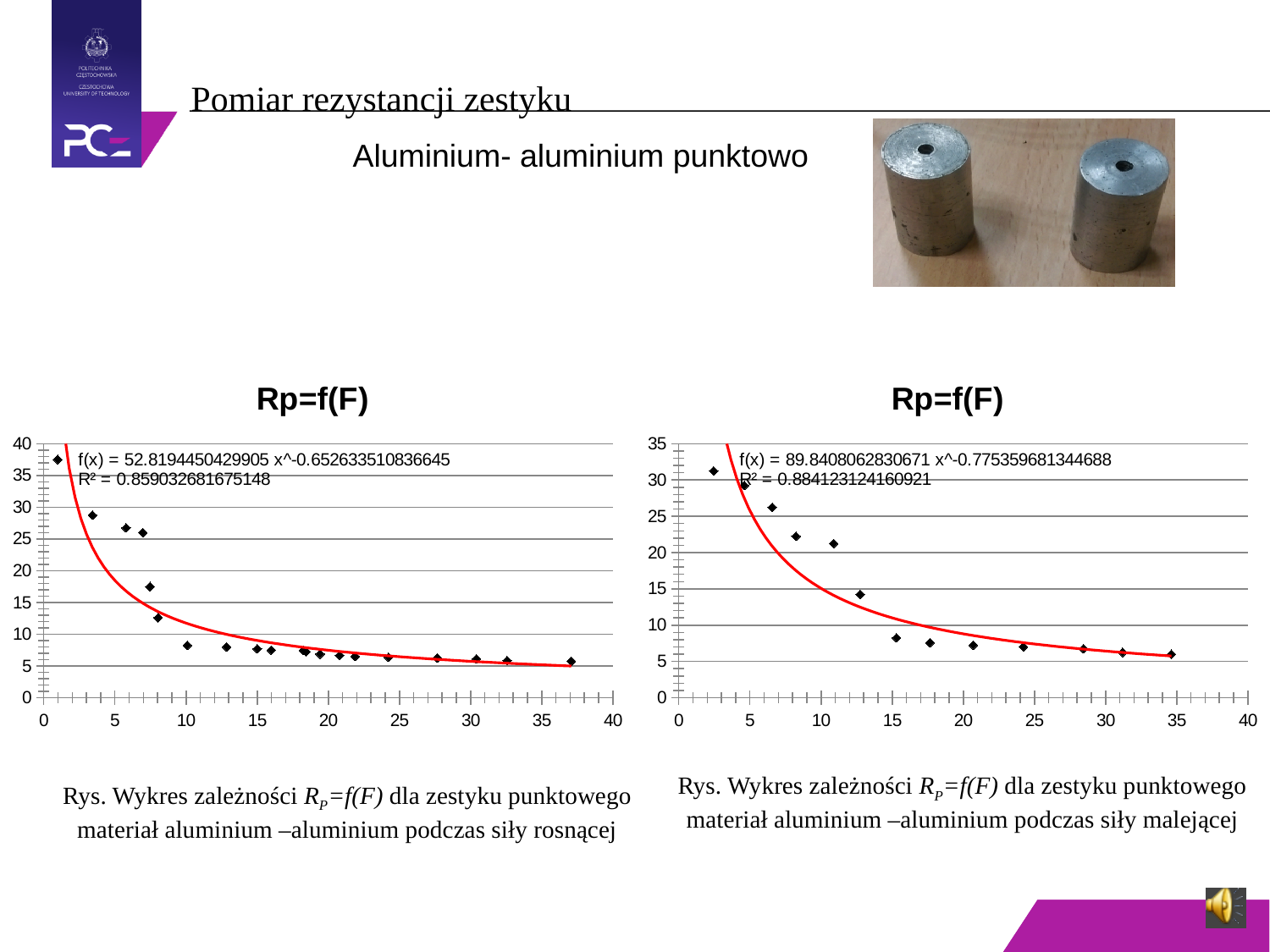
In the right chart, is the Rp value at about F=13 larger or smaller than the Rp value at about F=31? larger In the left chart, which plotted point has the highest Rp value: the leftmost point or the rightmost point? the leftmost point In the left chart, is the value of the first plotted point (near F=1) greater or less than 35? greater What R² value is printed on the right chart? 0.884123124160921 What kind of chart is the left chart titled Rp=f(F)? scatter chart In the left chart (siły rosnącej), do the plotted values rise or fall as F increases along the x axis? fall In the right chart (siły malejącej), do the plotted values rise or fall as F increases along the x axis? fall In the right chart, is the value of the first plotted point (near F=2.5) greater or less than 30? greater In the right chart, is the value of the last plotted point (near F=35) greater or less than 10? less What R² value is printed on the left chart? 0.859032681675148 What is the maximum value shown on the y axis of the right chart? 35